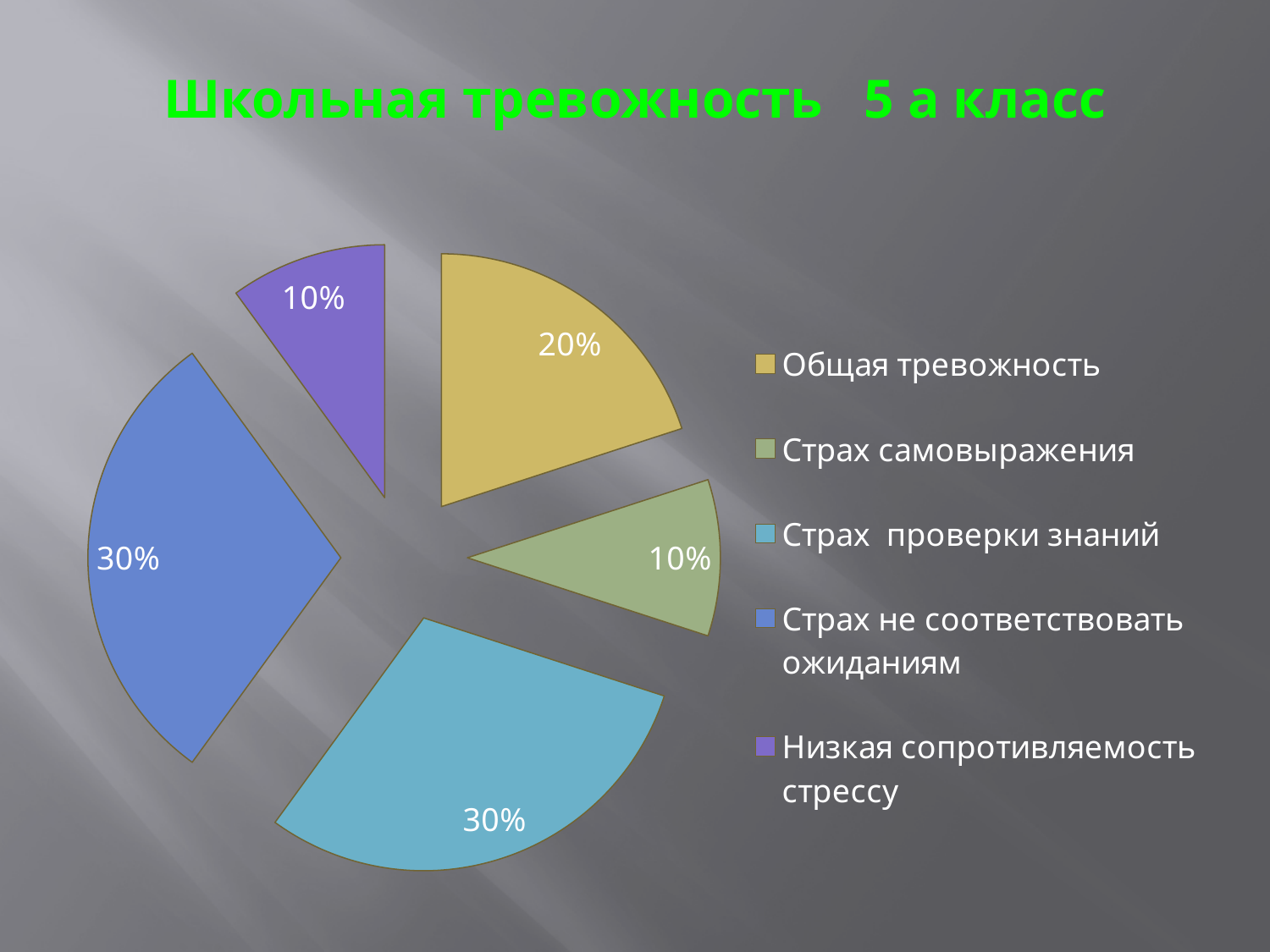
Which legend entry is shown in purple? Низкая сопротивляемость стрессу Which is larger: the slice for "Страх проверки знаний" or the slice for "Низкая сопротивляемость стрессу"? Страх проверки знаний What share of the pie does "Общая тревожность" have? 20% What share of the pie does "Низкая сопротивляемость стрессу" have? 10% What is the title of the chart on the slide? Школьная тревожность 5 а класс How many slices does the pie chart have? 5 What share of the pie does "Страх не соответствовать ожиданиям" have? 30% Which is larger: the slice for "Общая тревожность" or the slice for "Страх самовыражения"? Общая тревожность What share of the pie does "Страх проверки знаний" have? 30% What is the difference between the shares of "Страх не соответствовать ожиданиям" and "Общая тревожность"? 10% What share of the pie does "Страх самовыражения" have? 10% What kind of chart is shown on the slide? pie chart